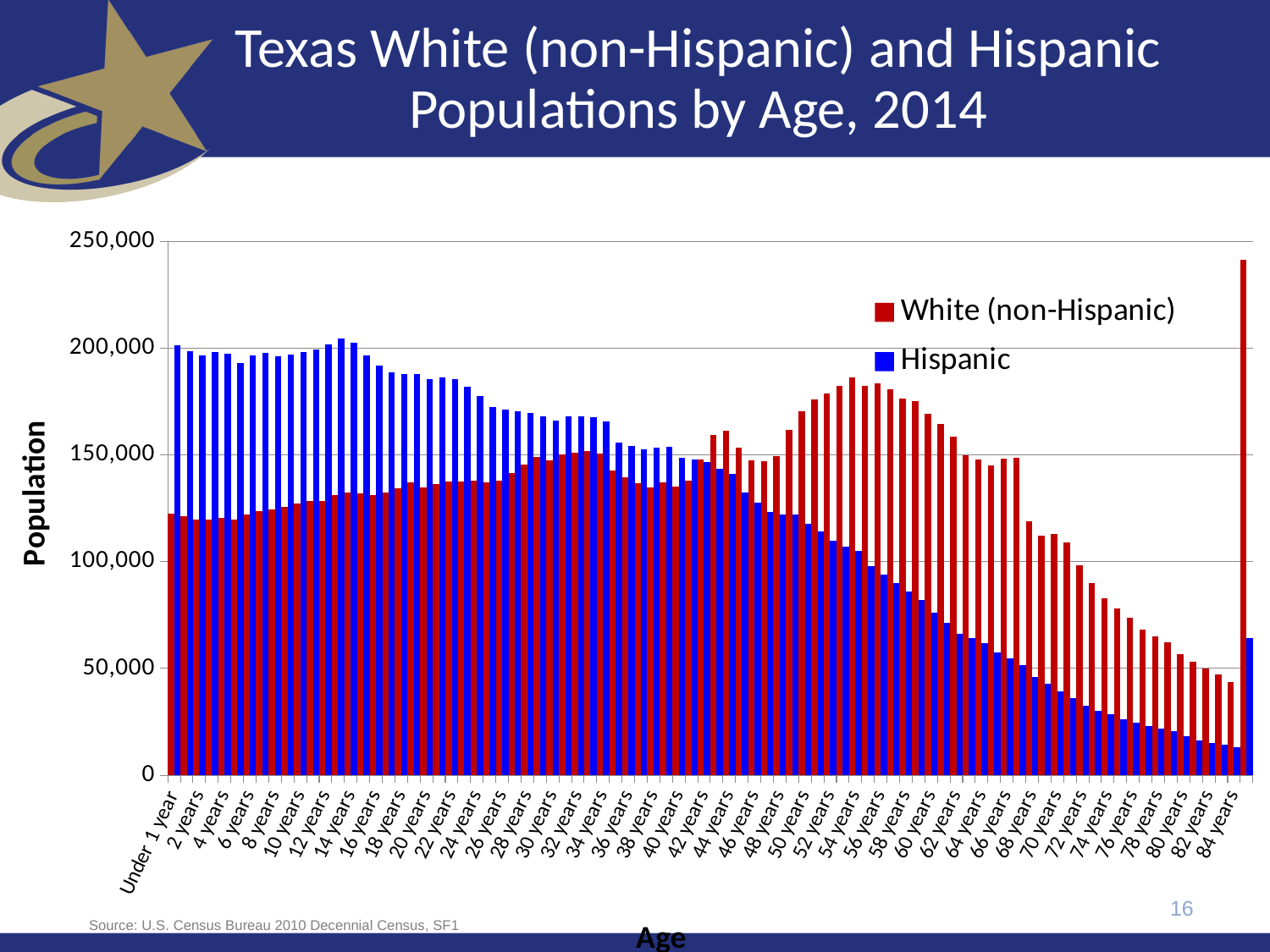
Is the White (non-Hispanic) value for 54 years greater or less than 150,000? greater What is the title of the chart? Texas White (non-Hispanic) and Hispanic Populations by Age, 2014 Is the Hispanic value for 84 years greater or less than 50,000? less How many series does the legend list? 2 At 70 years, which series has the larger value, White (non-Hispanic) or Hispanic? White (non-Hispanic) At 2 years, which series has the larger value, White (non-Hispanic) or Hispanic? Hispanic Is the Hispanic value for 14 years greater or less than 200,000? greater Which colour represents the Hispanic series? Blue What kind of chart is shown on the slide? Bar chart Do the Hispanic values generally rise or fall from 14 years to 84 years? Fall